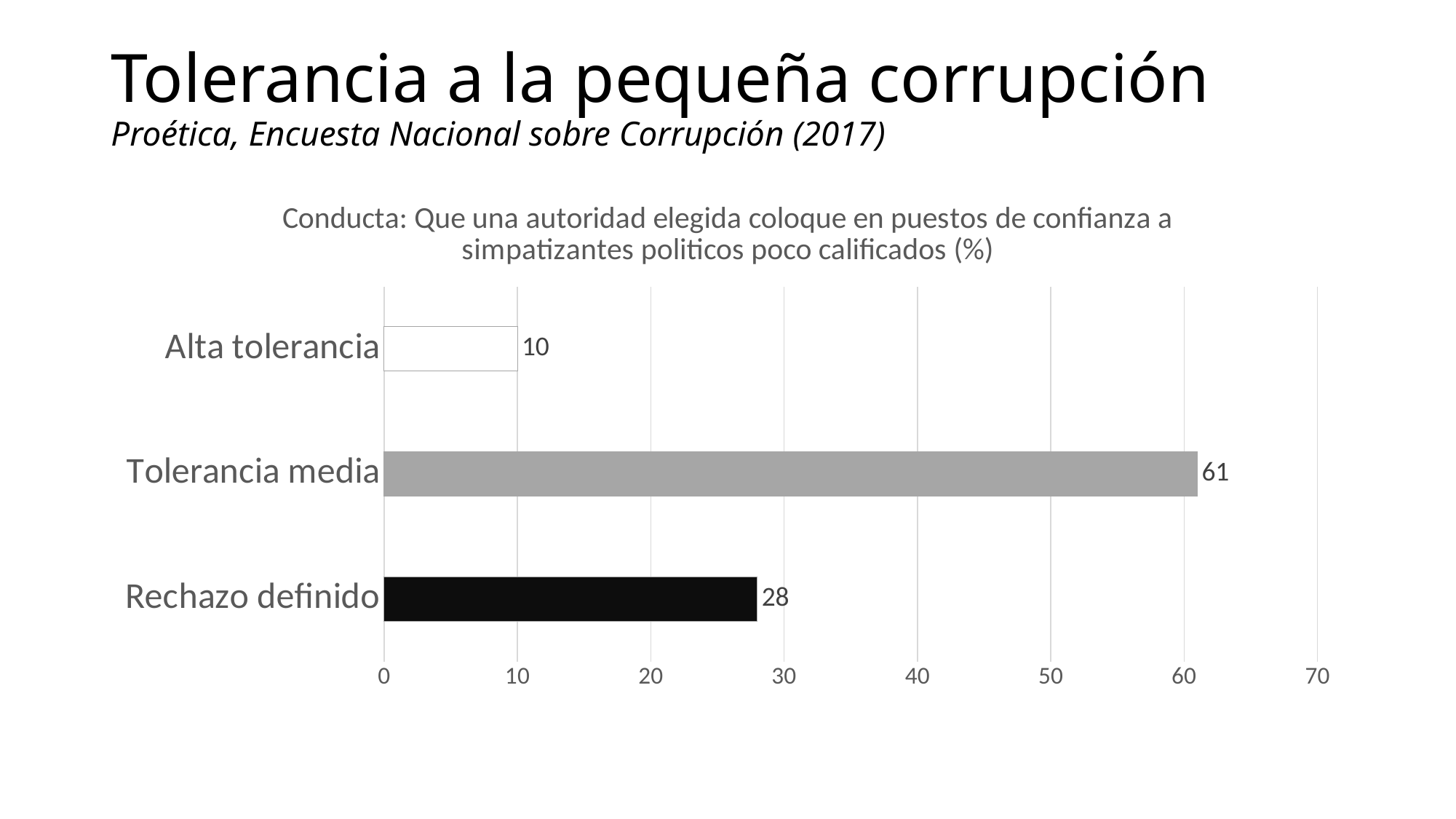
What is the value for Rechazo definido? 28 How many categories are shown in the chart? 3 What is the difference between the values for Tolerancia media and Rechazo definido? 33 What is the difference between the values for Rechazo definido and Alta tolerancia? 18 Which category has the highest value? Tolerancia media What is the source cited under the slide title? Proética, Encuesta Nacional sobre Corrupción (2017) Which category has the lowest value? Alta tolerancia What is the value for Tolerancia media? 61 Which is larger, the value for Rechazo definido or the value for Alta tolerancia? Rechazo definido Is the value for Tolerancia media greater or less than 50? greater What is the value for Alta tolerancia? 10 What kind of chart is shown on the slide? bar chart